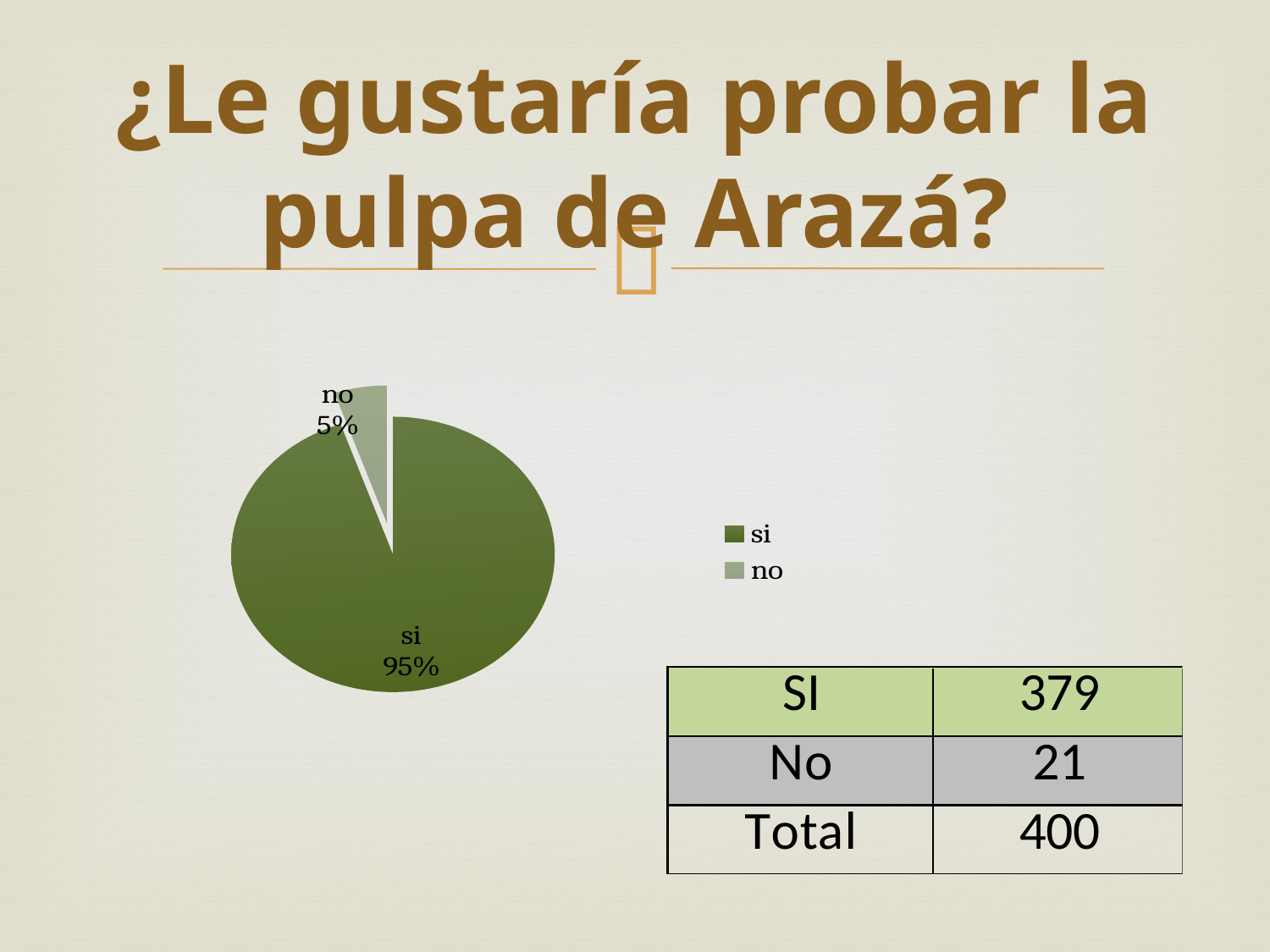
What question is the slide title asking? ¿Le gustaría probar la pulpa de Arazá? Which slice of the pie chart is the largest? si Which slice is larger, "si" or "no"? si What percentage of the pie chart is labelled "si"? 95% Is the share of the "si" slice greater or less than 50%? greater How many entries does the legend of the pie chart list? 2 What kind of chart is shown on the slide? pie chart How many slices does the pie chart have? 2 What percentage of the pie chart is labelled "no"? 5% Which slice of the pie chart is the smallest? no What colour is the "si" slice in the pie chart? dark green What is the difference in percentage points between the "si" slice and the "no" slice? 90